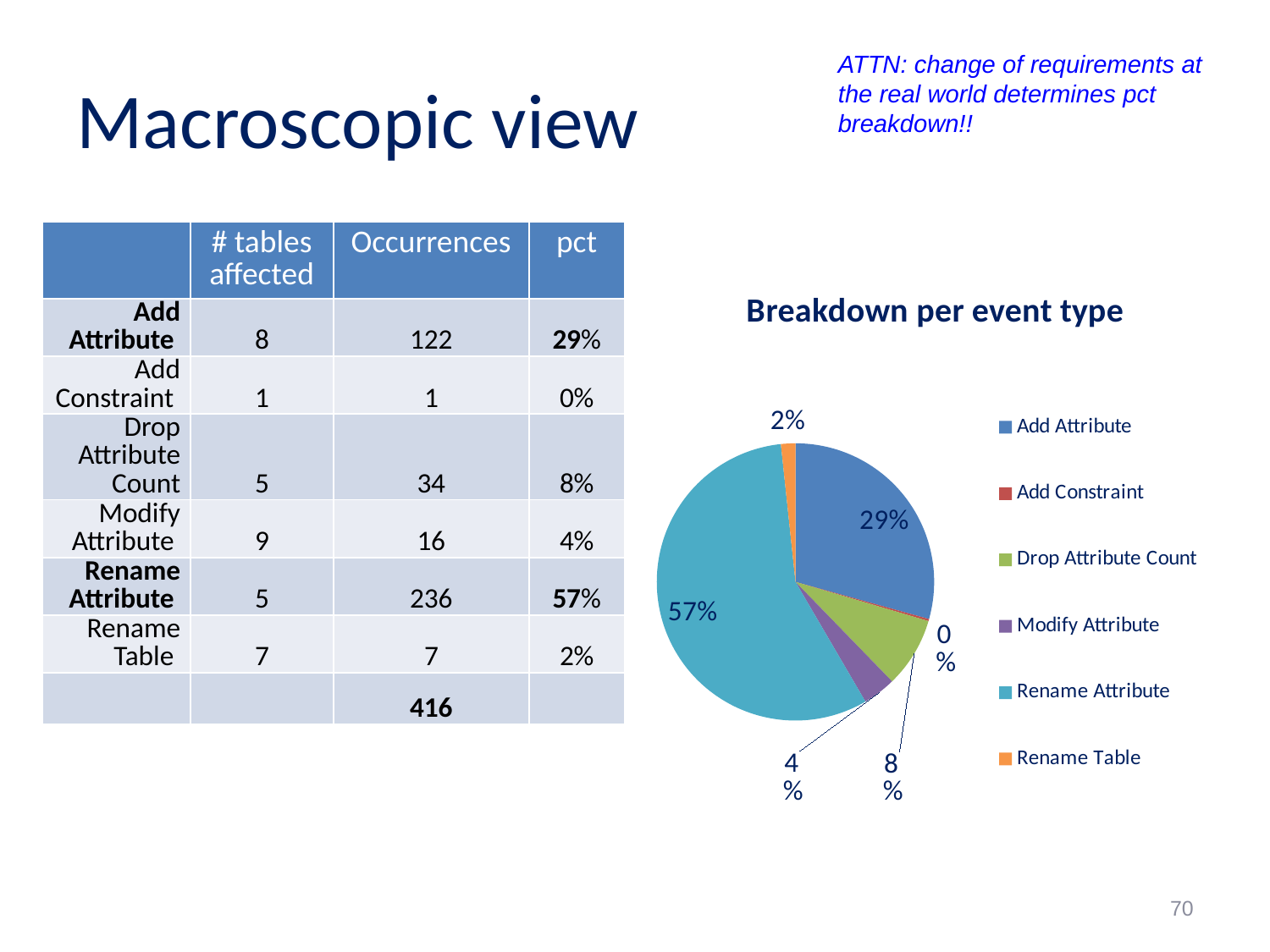
Which event type has the smallest slice of the pie? Add Constraint What share of the pie does Modify Attribute have? 4% What is the title of the pie chart? Breakdown per event type What kind of chart is shown on the slide? pie chart What share of the pie does Add Attribute have? 29% Which slice is larger, Drop Attribute Count or Modify Attribute? Drop Attribute Count How many entries does the legend of the pie chart list? 6 What is the difference in percentage points between the Rename Attribute and Add Attribute slices? 28 What share of the pie does Rename Table have? 2% Which event type has the largest slice of the pie? Rename Attribute